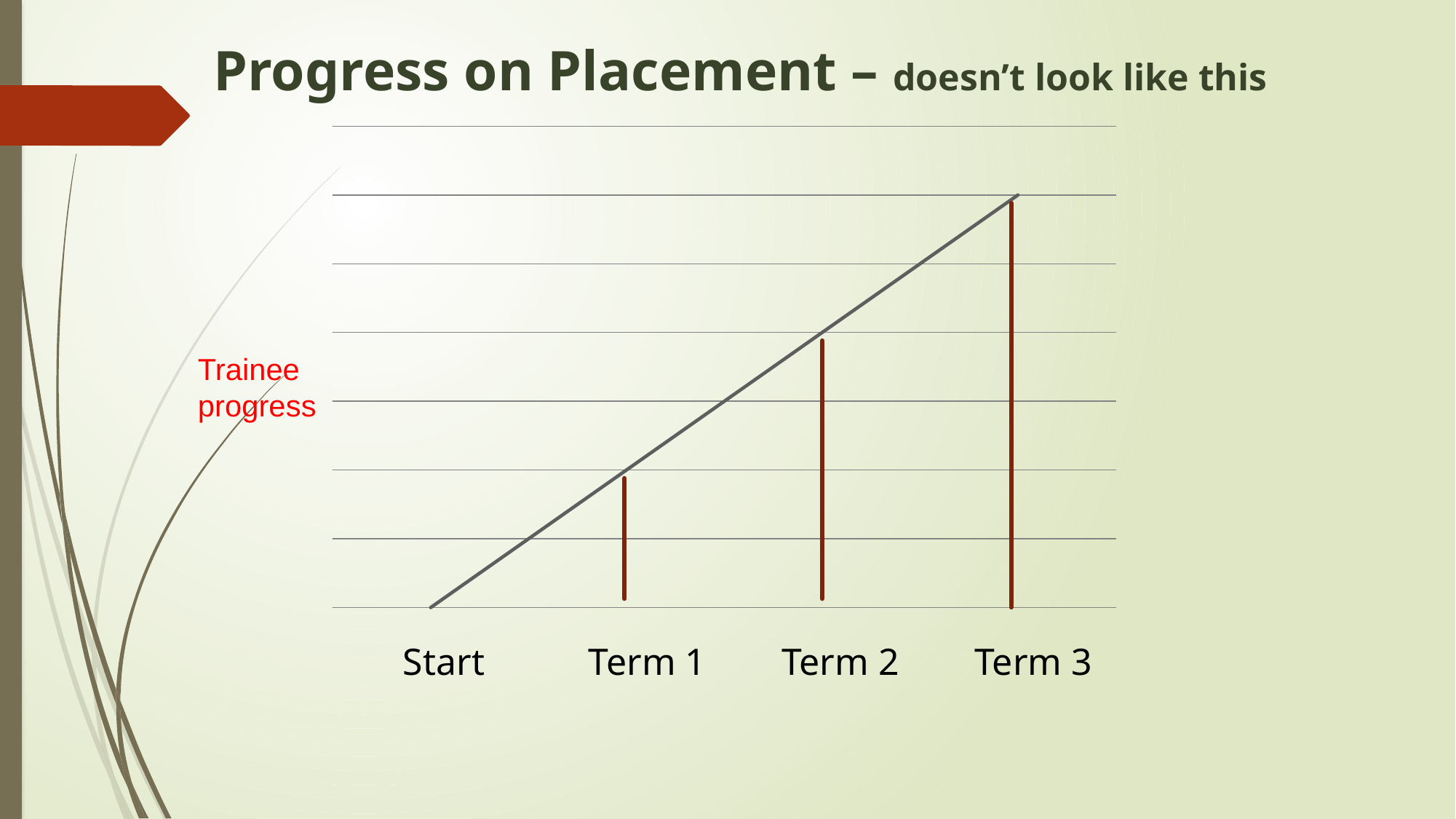
Which is higher on the chart, the trainee progress at Term 3 or at Term 2? Term 3 Does the trainee progress line rise or fall from Start to Term 3? rise What is the title of the slide containing the chart? Progress on Placement – doesn't look like this Which is higher on the chart, the trainee progress at Term 2 or at Term 1? Term 2 At which category does the trainee progress line reach its highest point? Term 3 What is the label written on the vertical axis of the chart? Trainee progress What are the category labels along the x axis of the chart? Start, Term 1, Term 2, Term 3 How many categories are labelled along the x axis of the chart? 4 At which category is the trainee progress line at its lowest point? Start Is the trainee progress line on the chart straight or curved? straight